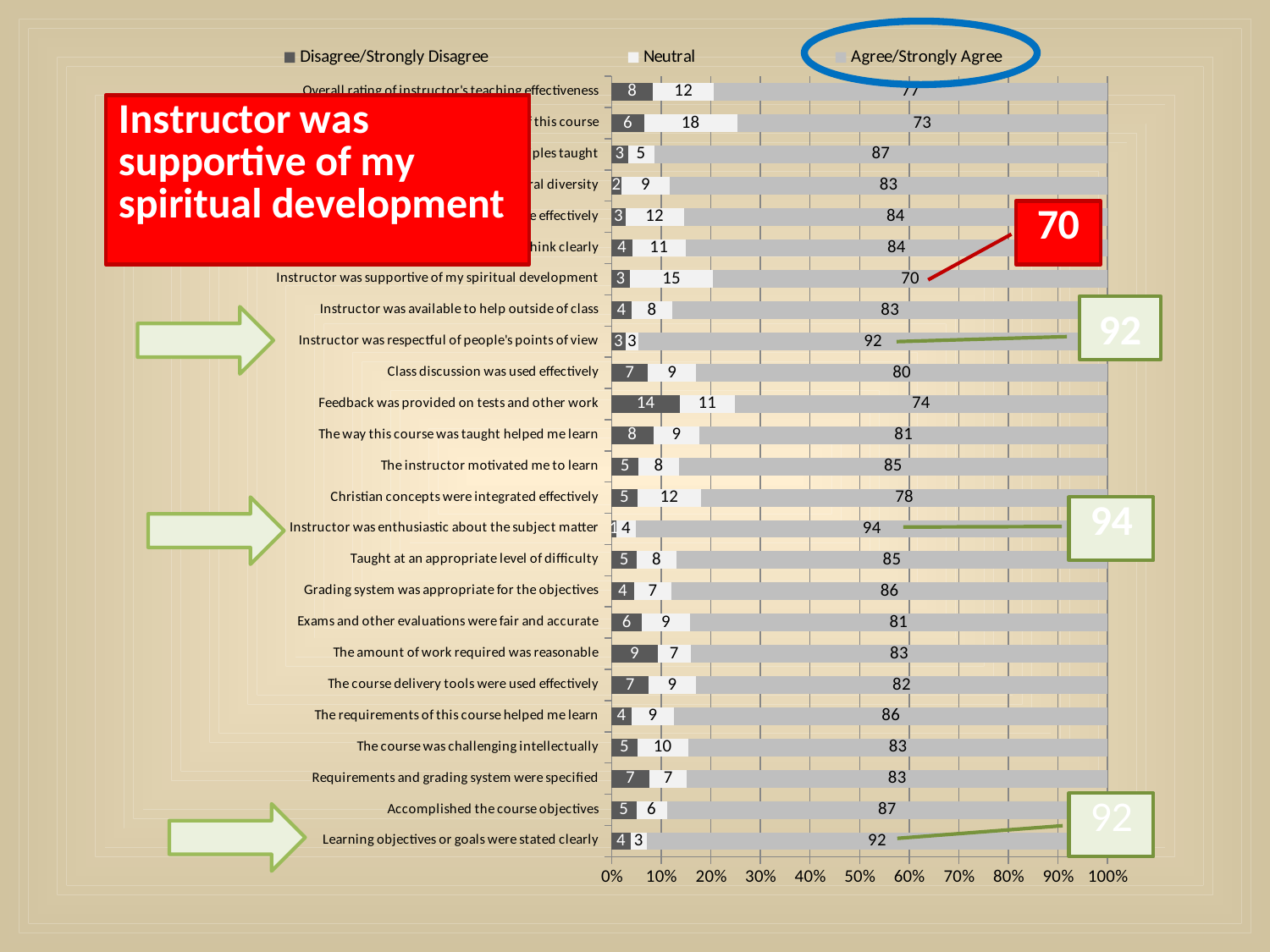
What is the Neutral value for 'Feedback was provided on tests and other work'? 11 What is the Agree/Strongly Agree value for 'Instructor was supportive of my spiritual development'? 70 Which category has the highest Disagree/Strongly Disagree value? Feedback was provided on tests and other work What is the total of the three segments for 'Learning objectives or goals were stated clearly'? 99 What is the difference between the Agree/Strongly Agree values for 'Instructor was enthusiastic about the subject matter' and 'Instructor was supportive of my spiritual development'? 24 How many categories (bars) are plotted in the chart? 25 Which category has the highest Agree/Strongly Agree value? Instructor was enthusiastic about the subject matter Which has a larger Agree/Strongly Agree value: 'Class discussion was used effectively' or 'The instructor motivated me to learn'? The instructor motivated me to learn What kind of chart is shown on the slide? Stacked bar chart What is the Disagree/Strongly Disagree value for 'The amount of work required was reasonable'? 9 How many series does the legend list? 3 Which legend entry is circled in blue at the top of the chart? Agree/Strongly Agree